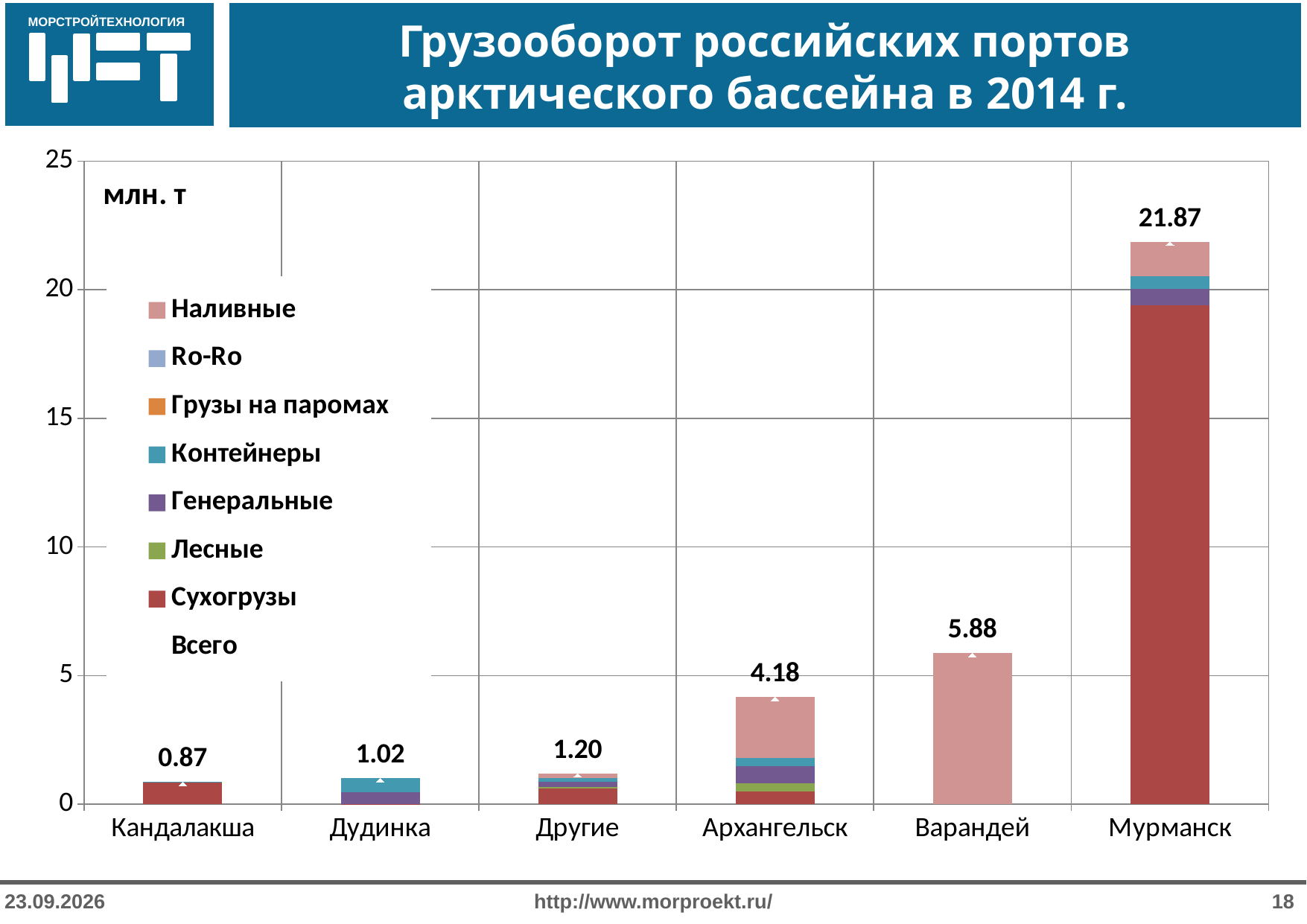
Which port has the lowest total cargo turnover? Кандалакша What is the total cargo turnover shown for Мурманск? 21.87 What unit of measurement is indicated on the chart? млн. т How many entries does the legend list? 8 Is the total for Варандей greater or less than 5? greater What is the total value labelled for Кандалакша? 0.87 What is the total value labelled for Архангельск? 4.18 How many ports (categories) are shown on the x axis? 6 What is the difference between the totals for Варандей and Архангельск? 1.70 What kind of chart is shown on the slide? Stacked bar chart Which port has the highest total cargo turnover? Мурманск Which has a larger total, Дудинка or Другие? Другие